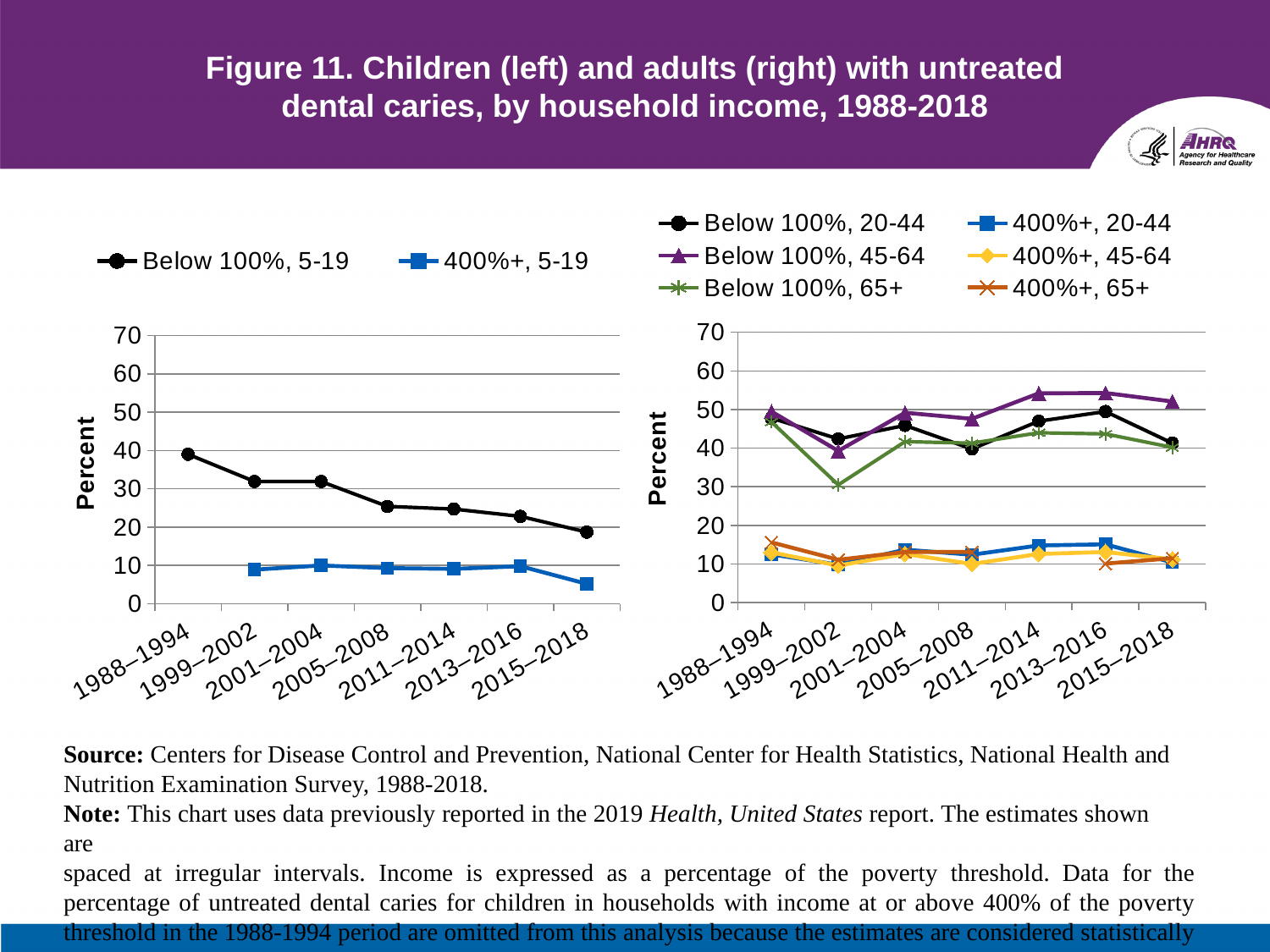
In the left chart (children, 5-19), is the value for 400%+, 5-19 in 2015–2018 greater or less than 10? less In the right chart (adults), which is larger in 1999–2002: Below 100%, 45-64 or Below 100%, 65+? Below 100%, 45-64 How many time periods are shown on the x axis of the left chart (children, 5-19)? 7 In the left chart (children, 5-19), is the value for Below 100%, 5-19 in 1988–1994 greater or less than 30? greater How many series does the legend of the left chart (children, 5-19) list? 2 In the left chart (children, 5-19), does the Below 100%, 5-19 series rise or fall from 1988–1994 to 2015–2018? fall In the right chart (adults), in which period does the Below 100%, 65+ series reach its lowest value? 1999–2002 In the right chart (adults), which series has the highest value in 2013–2016? Below 100%, 45-64 How many series does the legend of the right chart (adults) list? 6 What kind of chart is the left chart (children, 5-19)? line chart In the left chart (children, 5-19), how many data points are plotted for the 400%+, 5-19 series? 6 In the right chart (adults), is the value for Below 100%, 45-64 in 2011–2014 greater or less than 50? greater